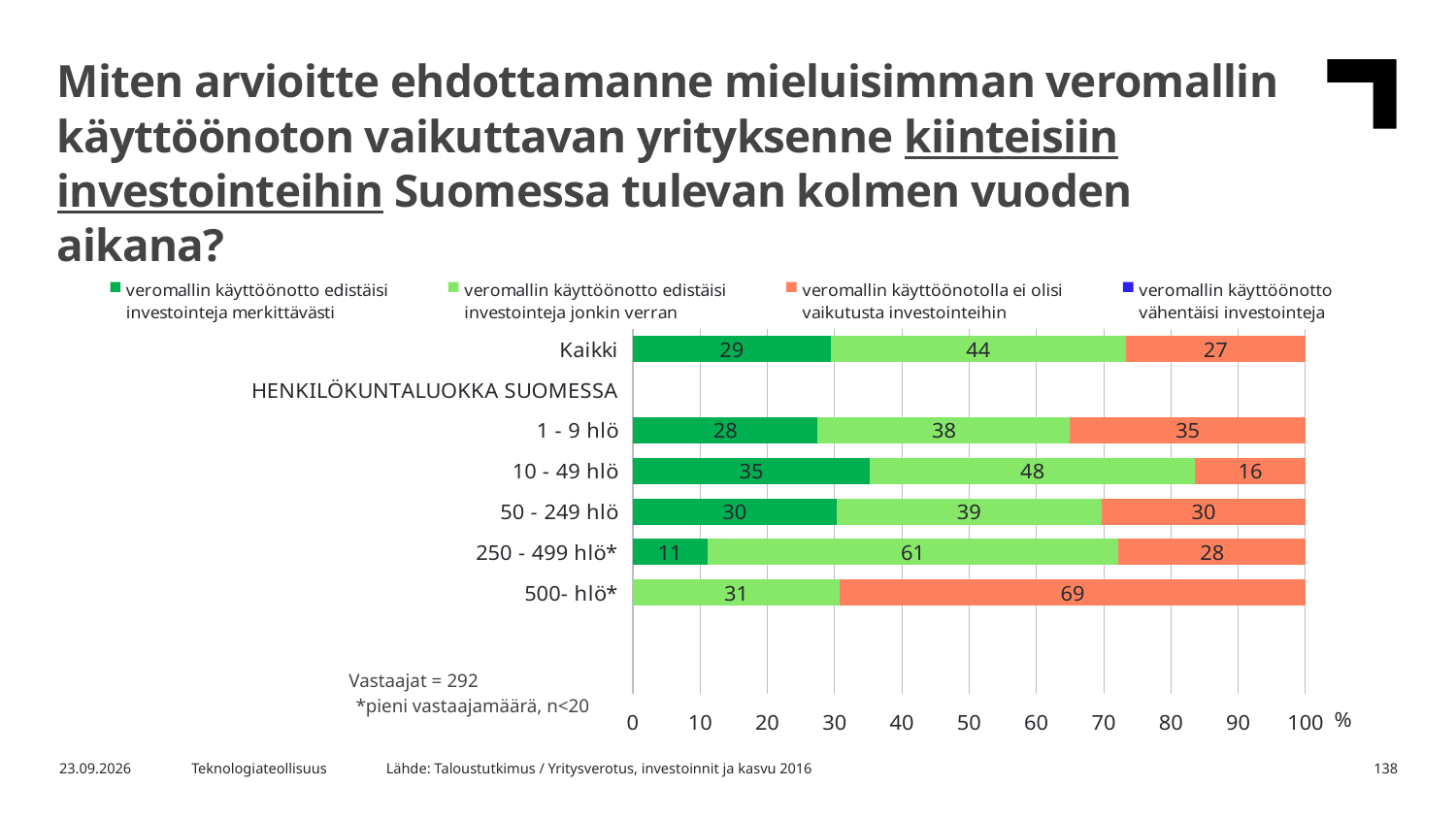
What is the number of respondents (Vastaajat) stated on the slide? 292 Which is larger: the 'veromallin käyttöönotolla ei olisi vaikutusta investointeihin' value for 1 - 9 hlö or for 50 - 249 hlö? 1 - 9 hlö What is the value for 'veromallin käyttöönotto edistäisi investointeja merkittävästi' in the Kaikki bar? 29 How many series does the legend list? 4 How many categories (bars) are plotted in the chart? 6 What is the value for 'veromallin käyttöönotto edistäisi investointeja jonkin verran' in the 250 - 499 hlö* bar? 61 Which category has the lowest value for 'veromallin käyttöönotolla ei olisi vaikutusta investointeihin'? 10 - 49 hlö What is the total of the 50 - 249 hlö stacked bar? 99 What kind of chart is shown on the slide? stacked bar chart Which category has the highest value for 'veromallin käyttöönotto edistäisi investointeja merkittävästi'? 10 - 49 hlö What is the value for 'veromallin käyttöönotolla ei olisi vaikutusta investointeihin' in the 500- hlö* bar? 69 What is the difference between the 'veromallin käyttöönotto edistäisi investointeja jonkin verran' values for 10 - 49 hlö and 1 - 9 hlö? 10